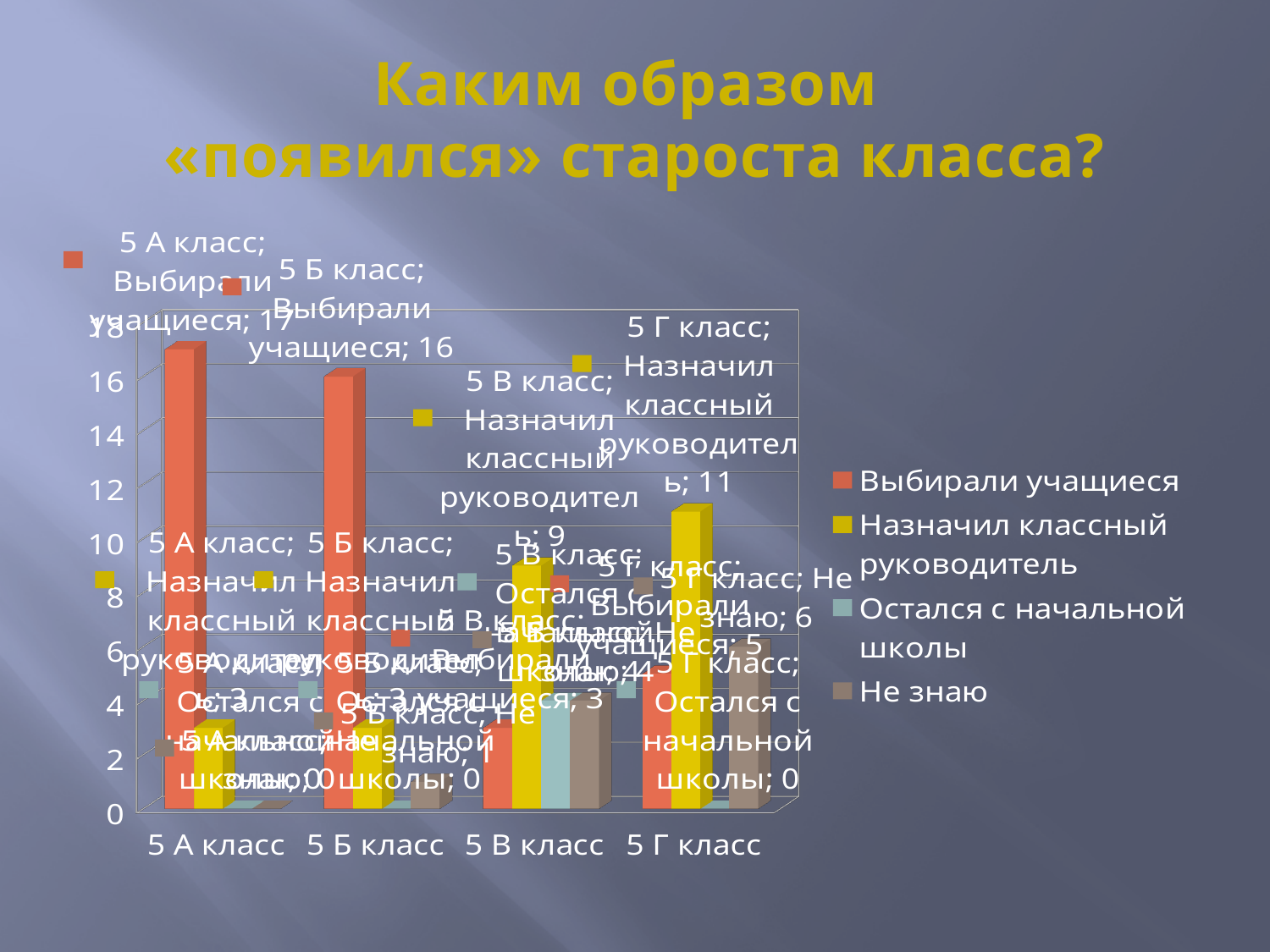
What type of chart is shown on the slide? Bar chart How many students in 5 А класс answered «Выбирали учащиеся»? 17 Which class has the highest value for «Выбирали учащиеся»? 5 А класс What is the value for «Выбирали учащиеся» in 5 Б класс? 16 What is the value for «Назначил классный руководитель» in 5 В класс? 9 How many classes (categories) are shown on the x axis? 4 How many series does the legend list? 4 What is the value for «Назначил классный руководитель» in 5 Г класс? 11 What is the value for «Не знаю» in 5 Г класс? 6 Which class has the larger value for «Назначил классный руководитель»: 5 В класс or 5 Г класс? 5 Г класс In 5 Г класс, how much larger is «Назначил классный руководитель» than «Выбирали учащиеся»? 6 What is the difference between the «Выбирали учащиеся» values for 5 А класс and 5 Б класс? 1